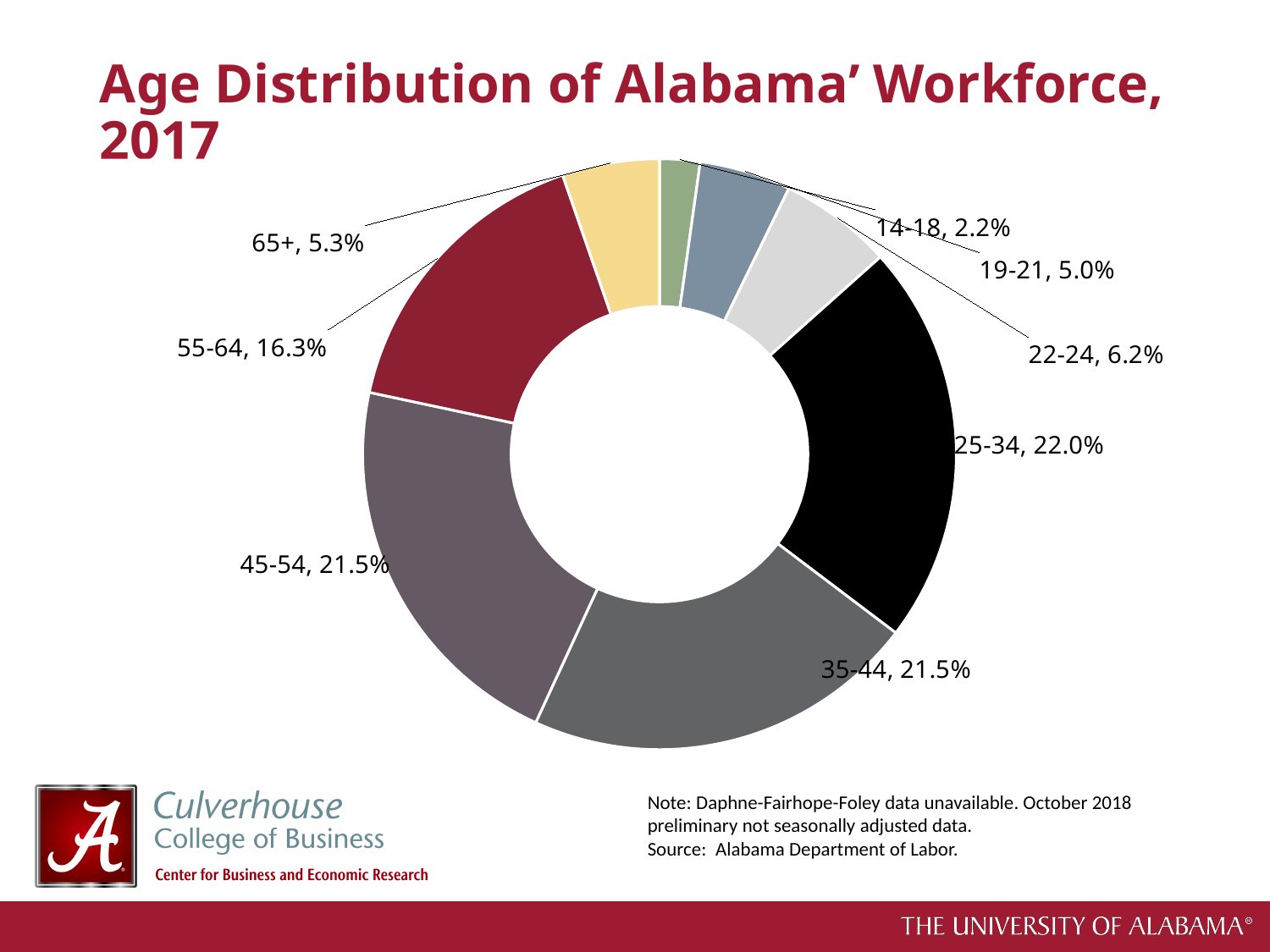
What type of chart is used on this slide? Doughnut chart What percentage of the workforce is aged 65+? 5.3% Which age group has the largest share of the workforce? 25-34 What is the title of the chart? Age Distribution of Alabama' Workforce, 2017 Which has a larger share of the workforce, the 22-24 group or the 19-21 group? 22-24 What is the difference in percentage points between the 25-34 and 55-64 age groups? 5.7 What share of Alabama's workforce in 2017 is aged 25-34? 22.0% What is the share for the 14-18 age group? 2.2% How many age groups are shown in the chart? 8 What percentage of the workforce is in the 55-64 age group? 16.3% Which two age groups have the same share of 21.5%? 35-44 and 45-54 Which age group has the smallest share of the workforce? 14-18